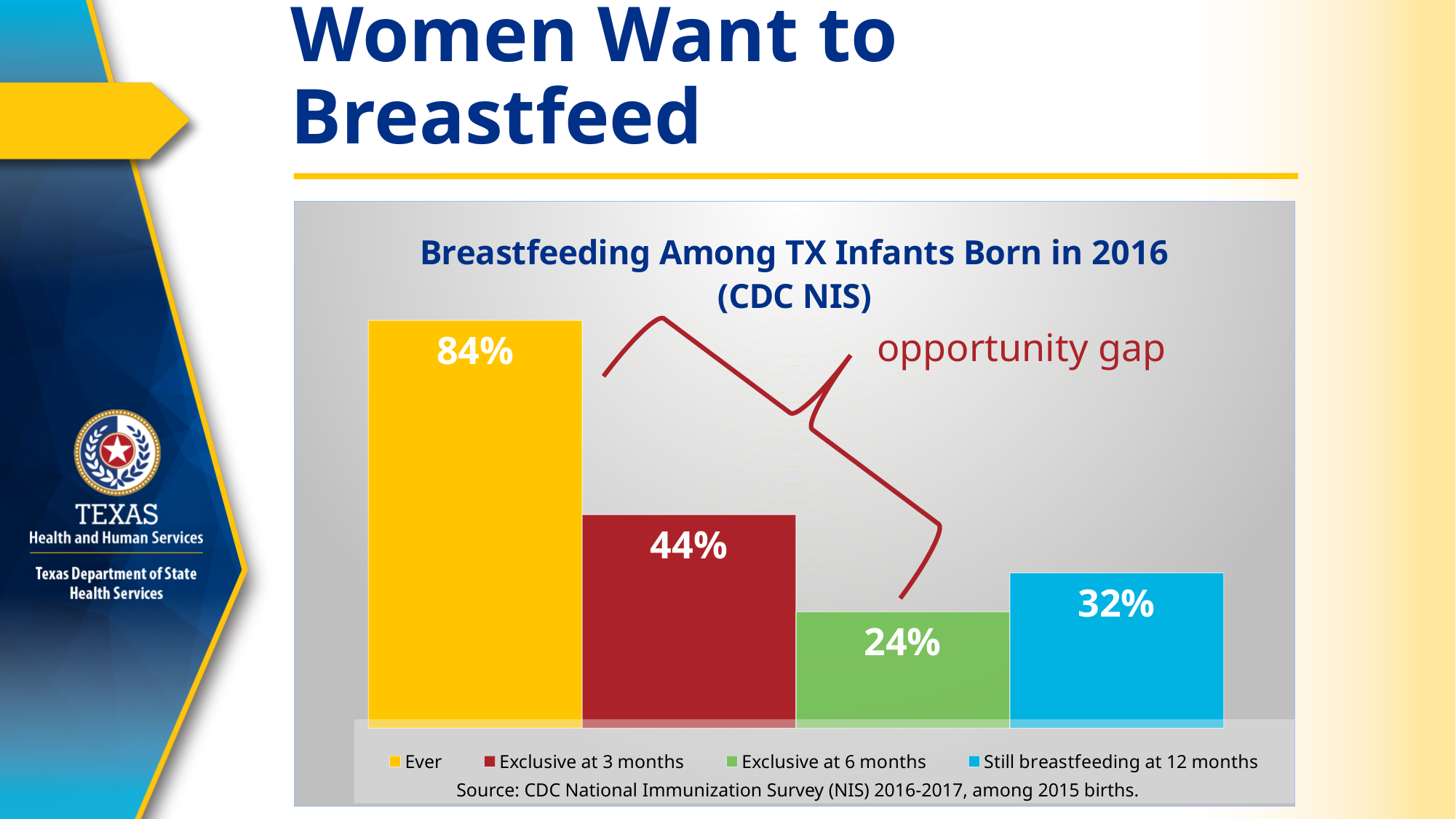
What is the value for Exclusive at 6 months? 24% What is the title of the chart? Breastfeeding Among TX Infants Born in 2016 (CDC NIS) What is the difference between the value for Ever and the value for Exclusive at 3 months? 40% What is the value for Ever? 84% Which is larger, the value for Exclusive at 3 months or the value for Still breastfeeding at 12 months? Exclusive at 3 months How many series does the legend list? 4 What kind of chart is shown on the slide? Bar chart What is the value for Still breastfeeding at 12 months? 32% Which series has the highest value? Ever What is the difference between the value for Still breastfeeding at 12 months and the value for Exclusive at 6 months? 8% What is the value for Exclusive at 3 months? 44% Which series has the lowest value? Exclusive at 6 months